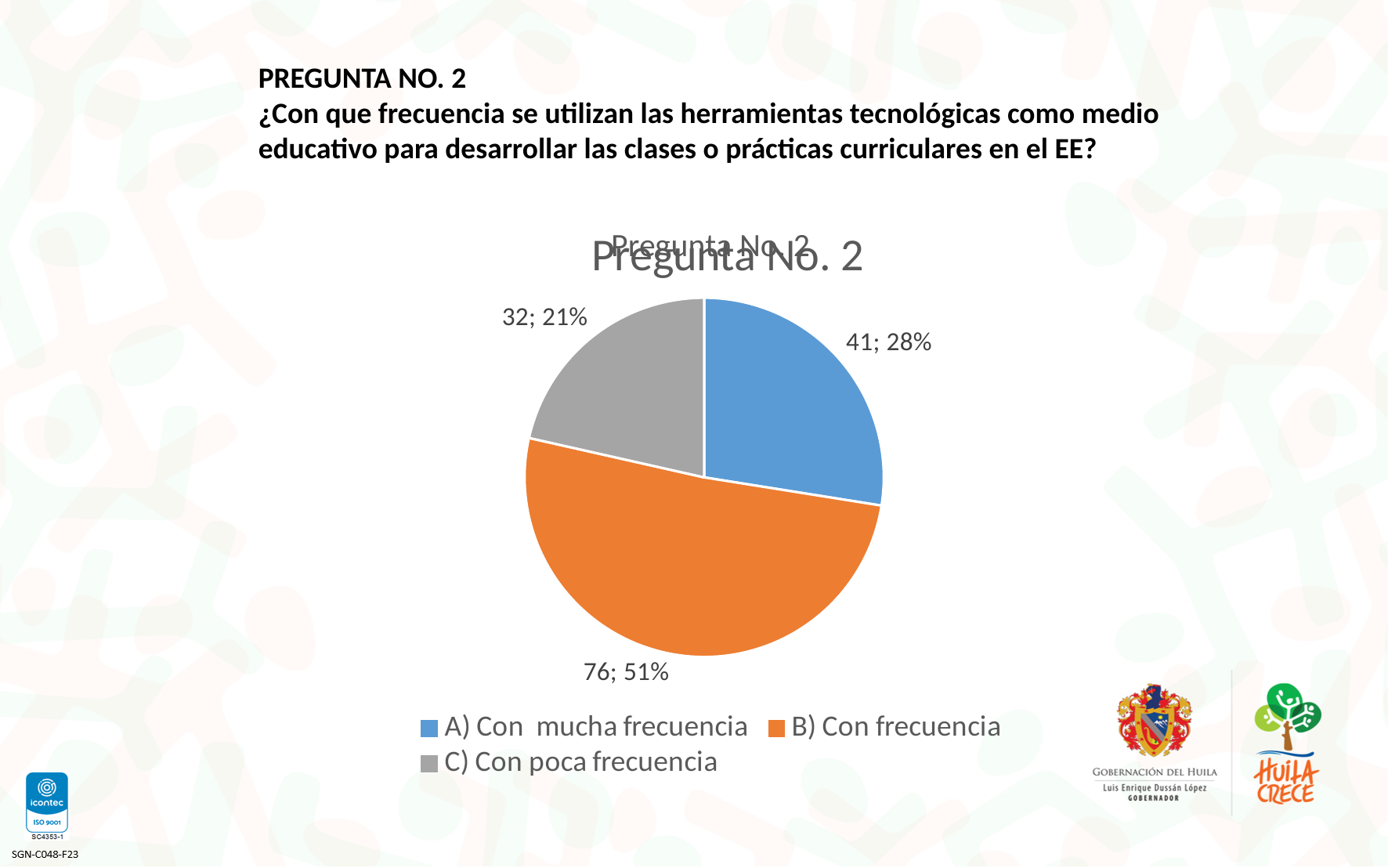
What is the total count across all three slices? 149 Which is larger, the count for "A) Con mucha frecuencia" or for "C) Con poca frecuencia"? A) Con mucha frecuencia How many categories does the pie chart have? 3 What kind of chart is shown on the slide? pie chart What percentage share does "C) Con poca frecuencia" have? 21% What percentage share does "A) Con mucha frecuencia" have? 28% Which category has the smallest slice? C) Con poca frecuencia What colour is the slice for "B) Con frecuencia"? orange Which category has the largest slice? B) Con frecuencia What is the count for "C) Con poca frecuencia"? 32 What is the difference in count between "B) Con frecuencia" and "A) Con mucha frecuencia"? 35 What is the count for "B) Con frecuencia"? 76